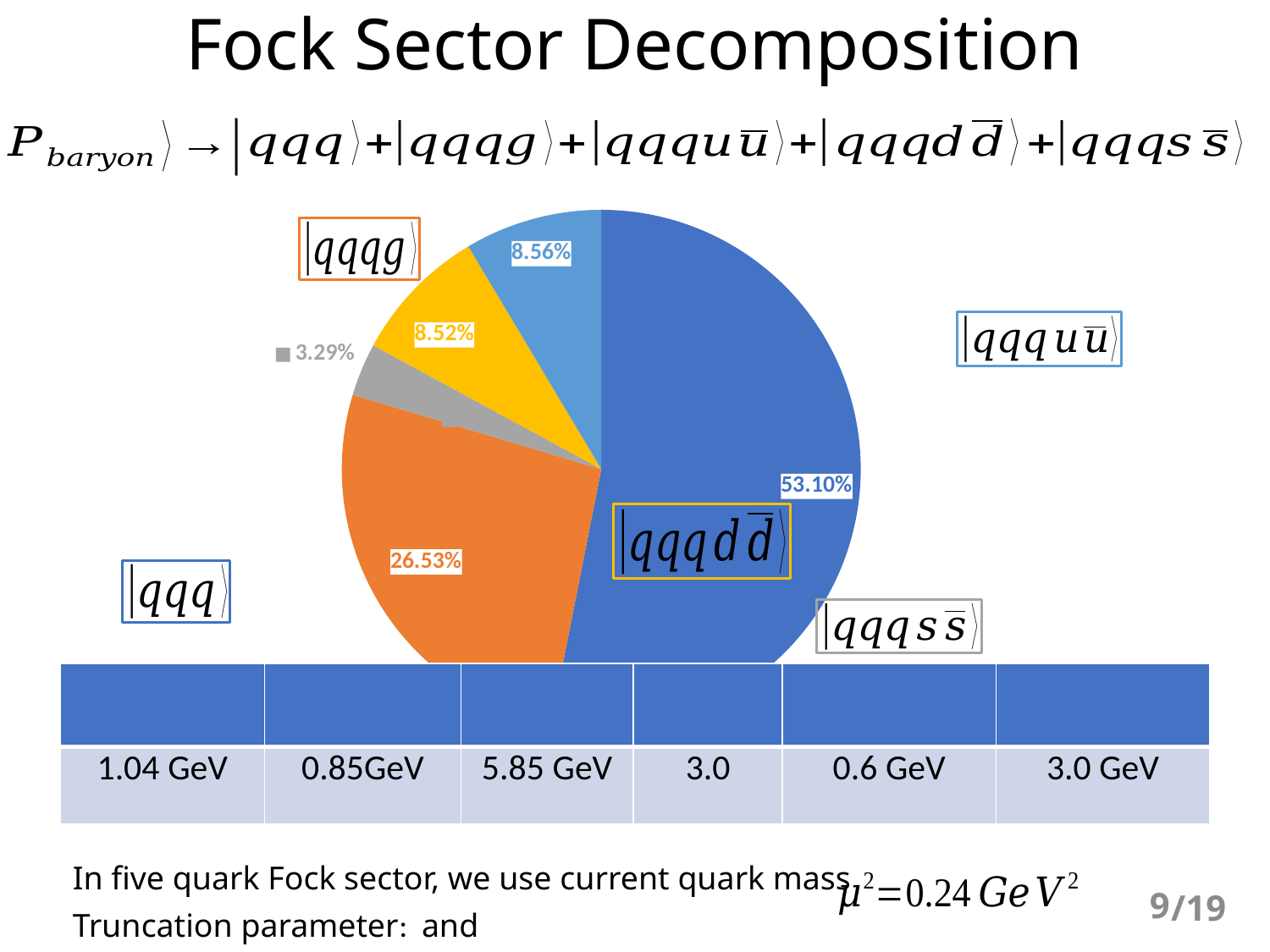
What is the difference between the largest slice (53.10%) and the orange slice (26.53%)? 26.57% What is the combined share of the yellow (8.52%) and light blue (8.56%) slices? 17.08% Which slice is larger, the orange slice or the yellow slice? the orange slice (26.53%) What is the percentage of the smallest slice in the pie chart? 3.29% What percentage is shown on the orange slice of the pie chart? 26.53% How many slices does the pie chart have? 5 What percentage is shown for the gray slice of the pie chart? 3.29% What is the percentage of the largest slice in the pie chart? 53.10% What is the title of the slide containing the pie chart? Fock Sector Decomposition What percentage is shown on the yellow slice of the pie chart? 8.52% What kind of chart is shown on the slide? pie chart What percentage is shown on the light blue slice of the pie chart? 8.56%